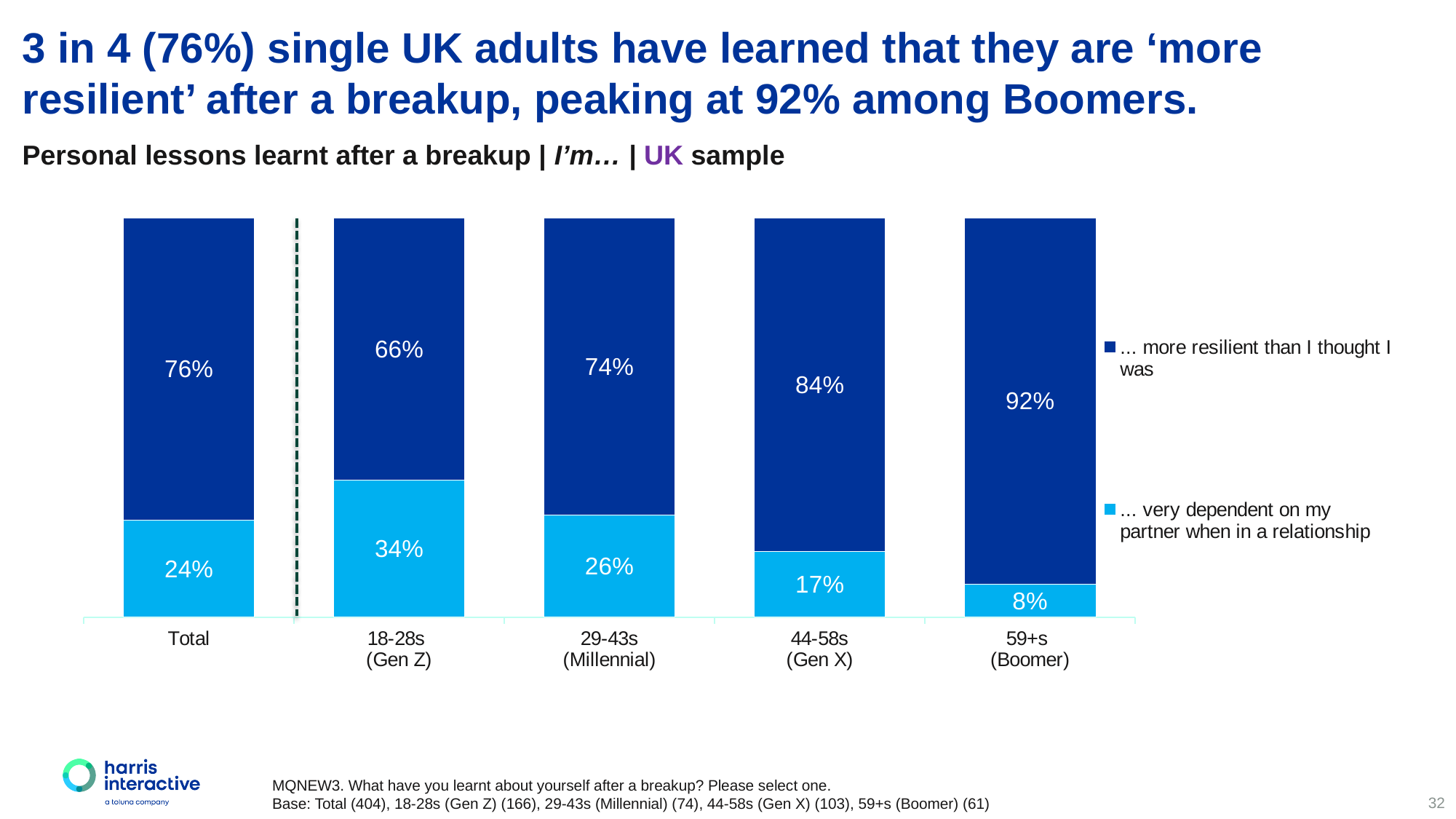
What is the difference between the '... more resilient than I thought I was' values for 59+s (Boomer) and 18-28s (Gen Z)? 26% What percentage of the Total sample said they are '... more resilient than I thought I was'? 76% Which is larger: the '... very dependent on my partner when in a relationship' value for 29-43s (Millennial) or for 44-58s (Gen X)? 29-43s (Millennial) How many series does the legend list? 2 Which age group has the highest '... more resilient than I thought I was' value? 59+s (Boomer) What is the total of the stacked bar for 29-43s (Millennial)? 100% What is the '... more resilient than I thought I was' value for 44-58s (Gen X)? 84% What percentage of 18-28s (Gen Z) said they are '... very dependent on my partner when in a relationship'? 34% What kind of chart is shown on the slide? Stacked bar chart How many categories are shown on the x axis? 5 Does the '... more resilient than I thought I was' value rise or fall from 18-28s (Gen Z) to 59+s (Boomer)? Rise Which age group has the lowest '... very dependent on my partner when in a relationship' value? 59+s (Boomer)